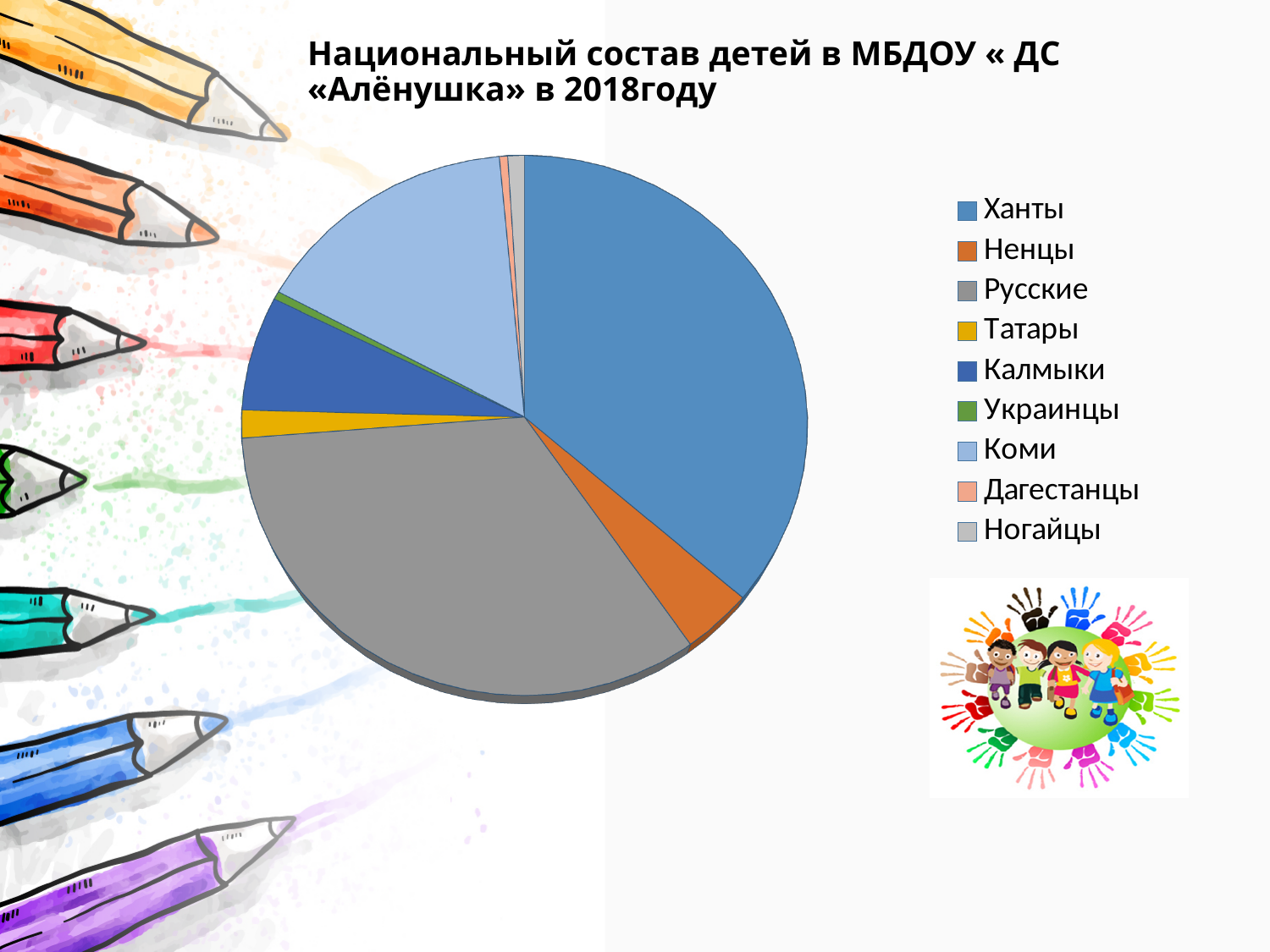
Which slice is larger, Ненцы or Татары? Ненцы Which slice is larger, Русские or Коми? Русские Which slice is larger, Ханты or Русские? Ханты How many nationalities (categories) does the pie chart's legend list? 9 What is the title of the chart? Национальный состав детей в МБДОУ « ДС «Алёнушка» в 2018году What colour is the slice for Татары in the pie chart? Yellow What kind of chart is shown on the slide? Pie chart Which nationality has the largest slice of the pie chart? Ханты